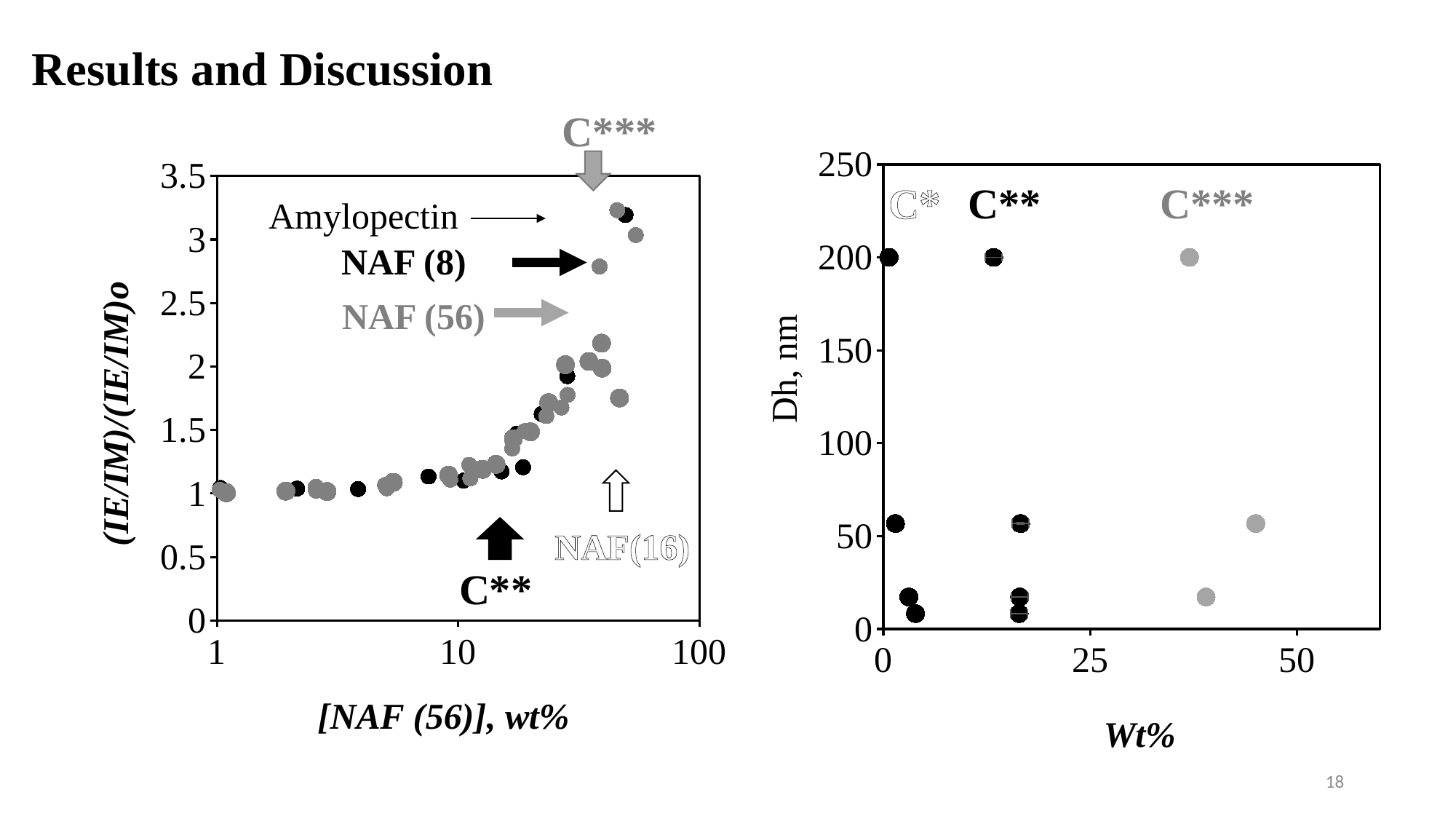
What is the y axis title of the right chart? Dh, nm What kind of chart is the right chart with y axis Dh, nm? scatter chart In the right chart, is the highest Dh value greater or less than 150 nm? greater What is the x axis title of the left chart? [NAF (56)], wt% In the left chart, do the (IE/IM)/(IE/IM)o values rise or fall as [NAF (56)], wt% increases? rise In the left chart, is the value at [NAF (56)] = 1 wt% greater or less than 2? less In the right chart, is the lowest Dh value greater or less than 50 nm? less What kind of chart is the left chart with x axis [NAF (56)], wt%? scatter chart